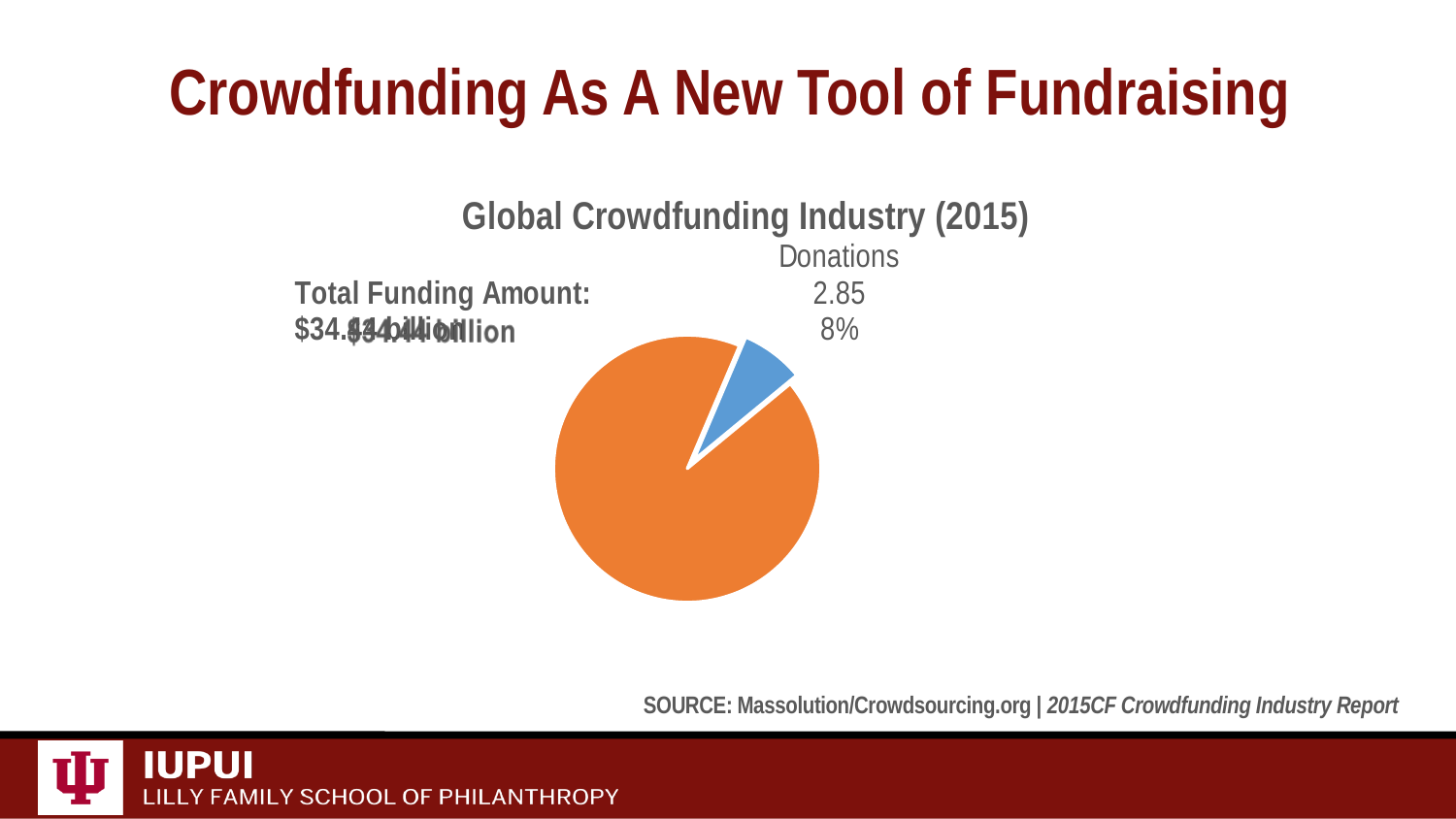
What kind of chart is shown on the slide? Pie chart What colour is the Donations slice in the pie chart? Blue What is the title of the chart? Global Crowdfunding Industry (2015) Which slice is larger: the Donations slice or the unlabeled orange slice? The unlabeled orange slice Which slice of the pie chart is the smallest? Donations What share of the pie does the Donations slice represent? 8% What value is shown for the Donations slice of the pie chart? 2.85 How many slices does the pie chart have? 2